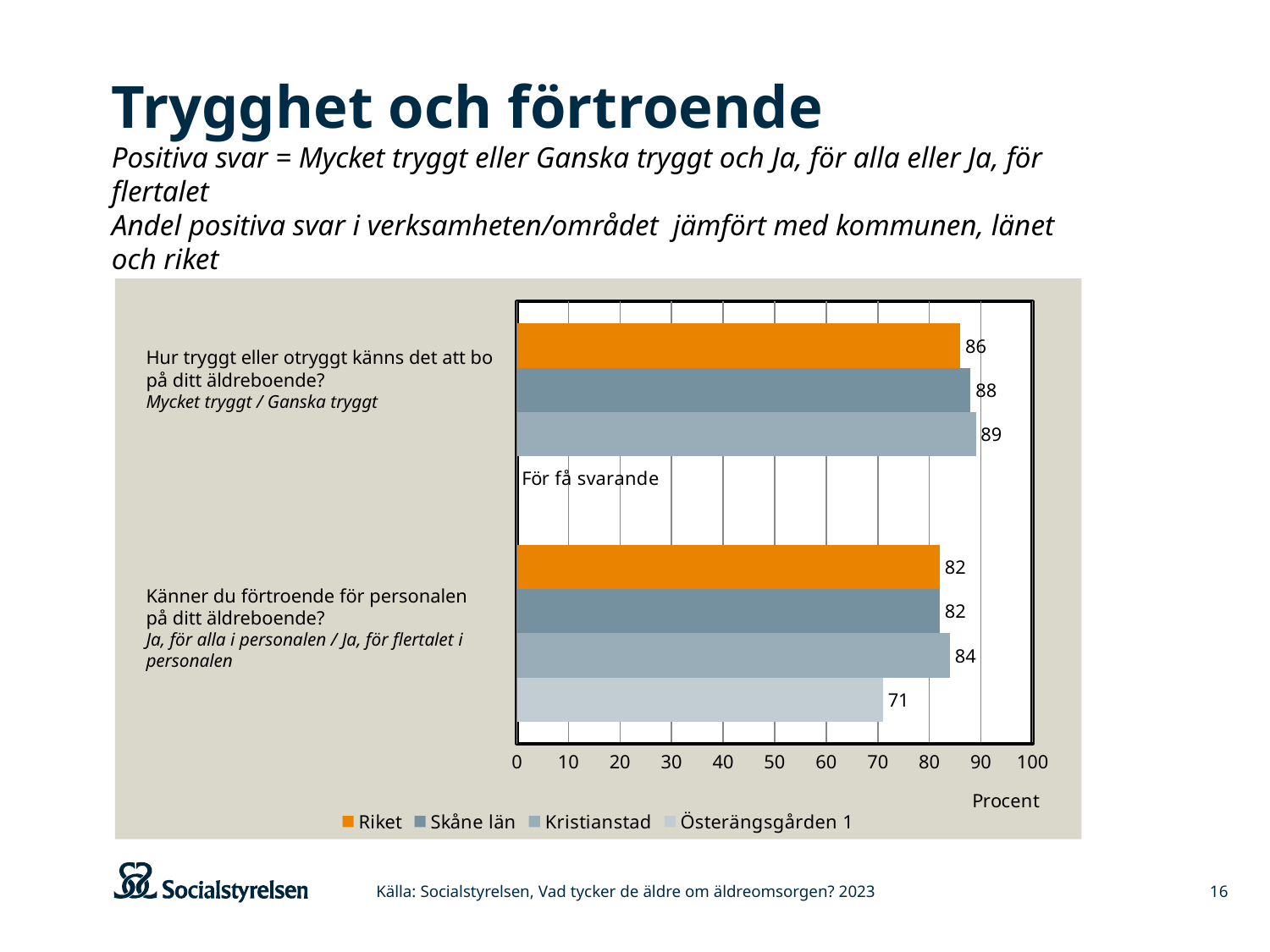
Which series has the highest value on the question "Känner du förtroende för personalen på ditt äldreboende?"? Kristianstad What is shown instead of a bar for Österängsgården 1 on the question "Hur tryggt eller otryggt känns det att bo på ditt äldreboende?"? För få svarande Which series has the lowest value on the question "Känner du förtroende för personalen på ditt äldreboende?"? Österängsgården 1 What kind of chart is shown on the slide? Bar chart What value is shown for Skåne län on the question "Känner du förtroende för personalen på ditt äldreboende?"? 82 What value is shown for Österängsgården 1 on the question "Känner du förtroende för personalen på ditt äldreboende?"? 71 What value is shown for Riket on the question "Hur tryggt eller otryggt känns det att bo på ditt äldreboende?"? 86 What value is shown for Kristianstad on the question "Hur tryggt eller otryggt känns det att bo på ditt äldreboende?"? 89 What is the difference between Kristianstad and Riket on the question "Hur tryggt eller otryggt känns det att bo på ditt äldreboende?"? 3 What is the difference between Kristianstad and Österängsgården 1 on the question "Känner du förtroende för personalen på ditt äldreboende?"? 13 How many series does the legend list? 4 Which is larger: Skåne län on the trygghet question or Skåne län on the förtroende question? Skåne län on the trygghet question